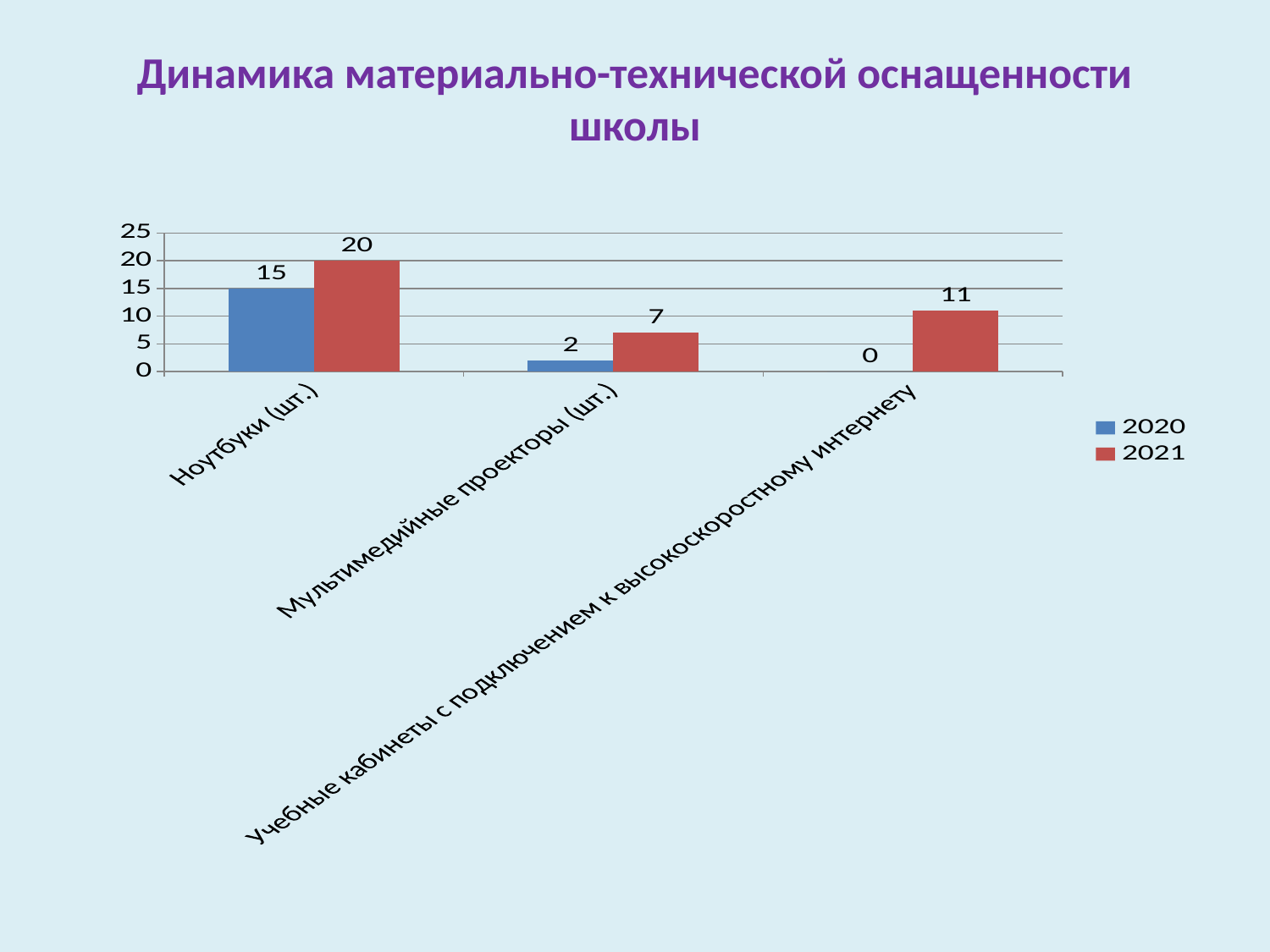
What is the value for Учебные кабинеты с подключением к высокоскоростному интернету in 2020? 0 What is the difference between the 2021 and 2020 values for Мультимедийные проекторы (шт.)? 5 How many categories are shown on the x axis? 3 Which category has the highest value in 2021? Ноутбуки (шт.) Which is larger: the 2021 value for Мультимедийные проекторы (шт.) or the 2021 value for Учебные кабинеты с подключением к высокоскоростному интернету? Учебные кабинеты с подключением к высокоскоростному интернету What is the value for Ноутбуки (шт.) in 2021? 20 What is the difference between the 2021 and 2020 values for Ноутбуки (шт.)? 5 How many series does the legend list? 2 Which category has the lowest value in 2020? Учебные кабинеты с подключением к высокоскоростному интернету What is the value for Мультимедийные проекторы (шт.) in 2021? 7 What kind of chart is shown on the slide? Bar chart What is the value for Ноутбуки (шт.) in 2020? 15